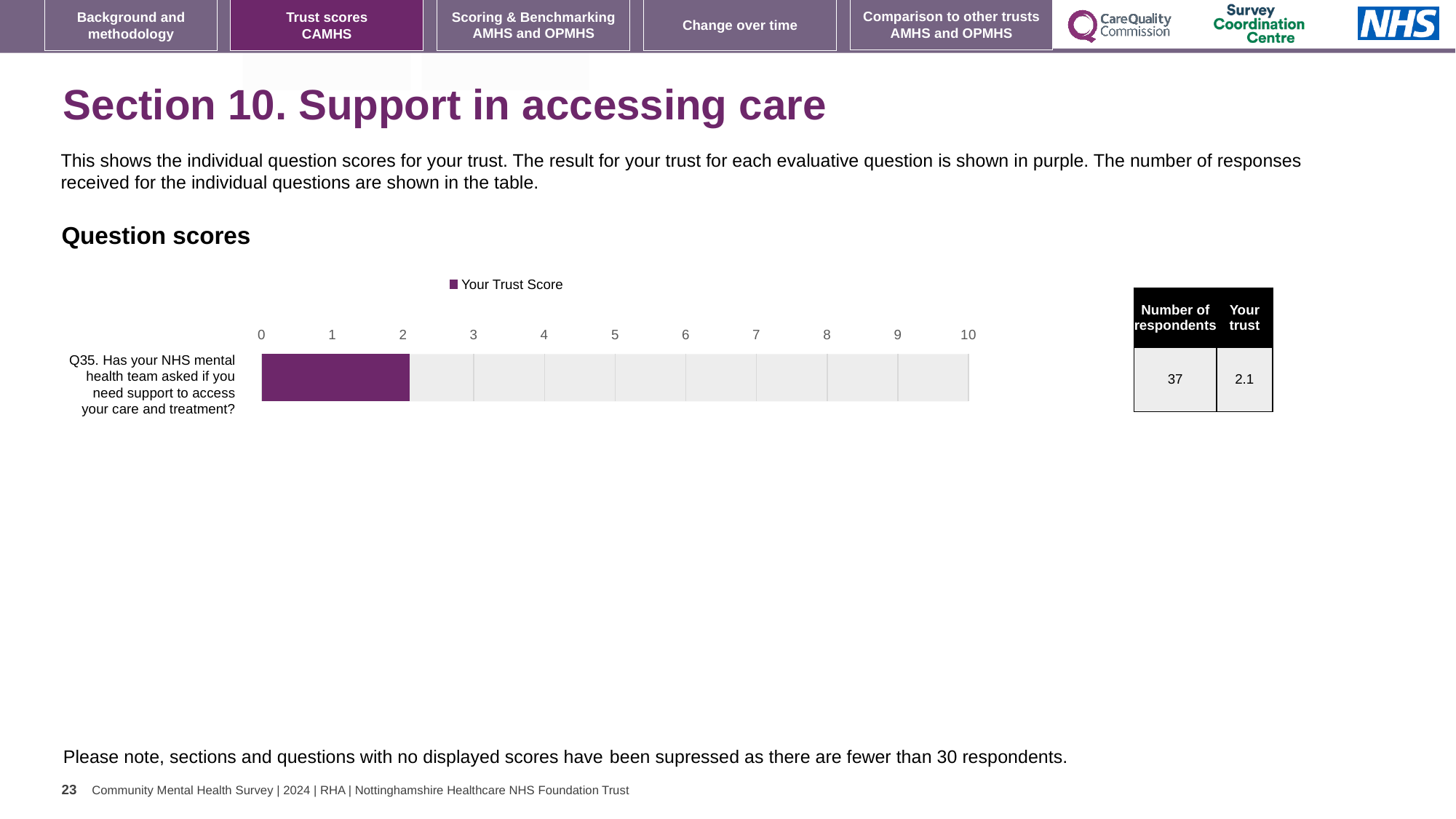
Is the value for Q35 greater or less than 3? less Is the value for Q35 greater or less than 1? greater What is the legend entry shown above the Question scores chart? Your Trust Score What is the trust score for Q35 (Has your NHS mental health team asked if you need support to access your care and treatment?)? 2.1 How many respondents answered Q35 according to the table beside the chart? 37 Is the value for Q35 greater or less than 5? less What kind of chart is shown under 'Question scores'? bar chart How many series does the legend of the Question scores chart list? 1 How many questions (categories) are plotted in the Question scores chart? 1 What colour is the bar representing Your Trust Score in the Question scores chart? purple